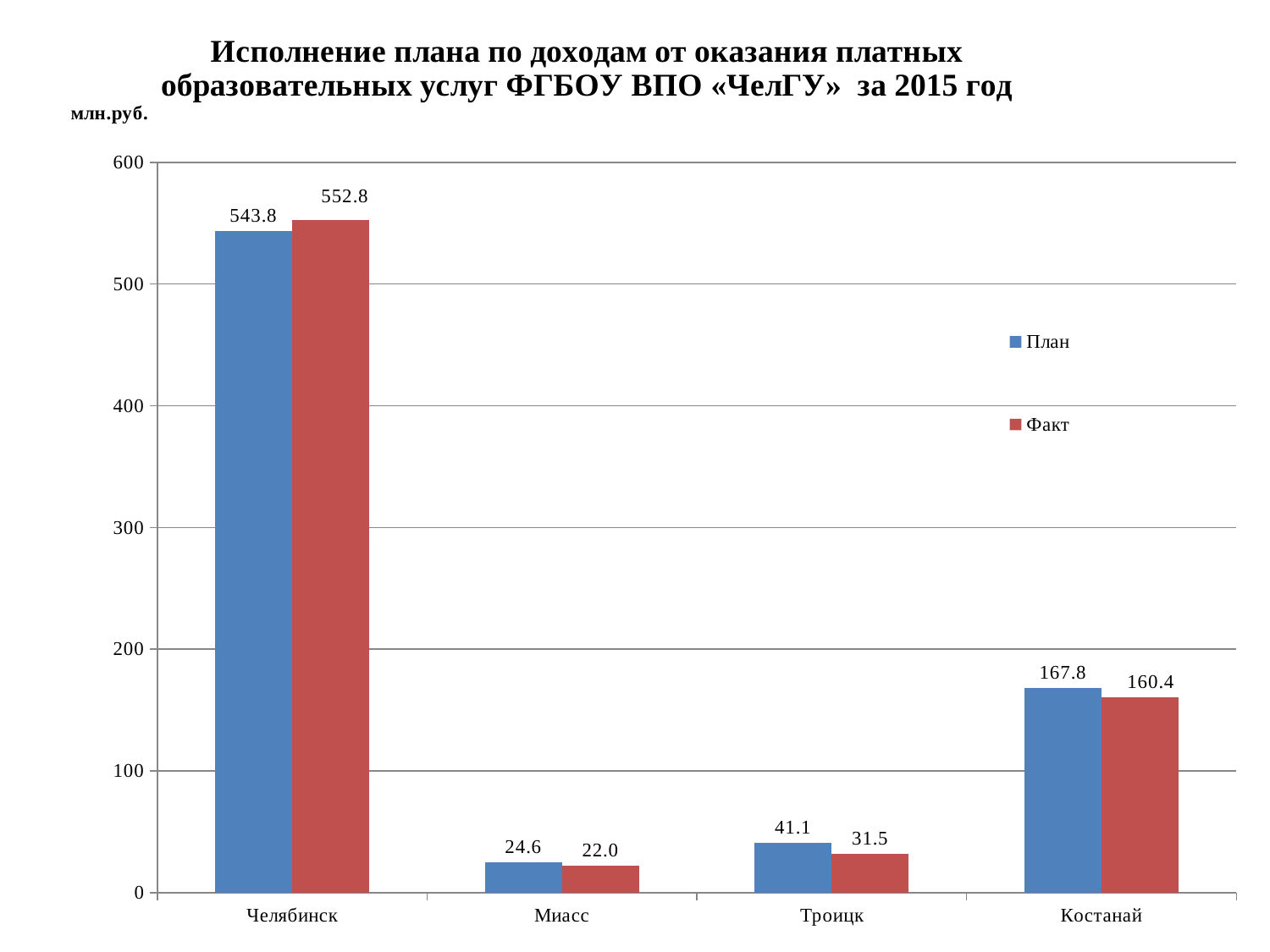
Which category has the highest Факт value? Челябинск How many categories are shown on the x axis? 4 Is the План value for Костанай greater or less than 200? less What is the Факт value for Костанай? 160.4 Which category has the lowest План value? Миасс What unit is indicated for the y axis? млн.руб. How many series does the legend list? 2 What kind of chart is shown on the slide? bar chart Which is larger for Челябинск, План or Факт? Факт What is the Факт value for Миасс? 22.0 What is the difference between План and Факт for Троицк? 9.6 What is the План value for Челябинск? 543.8